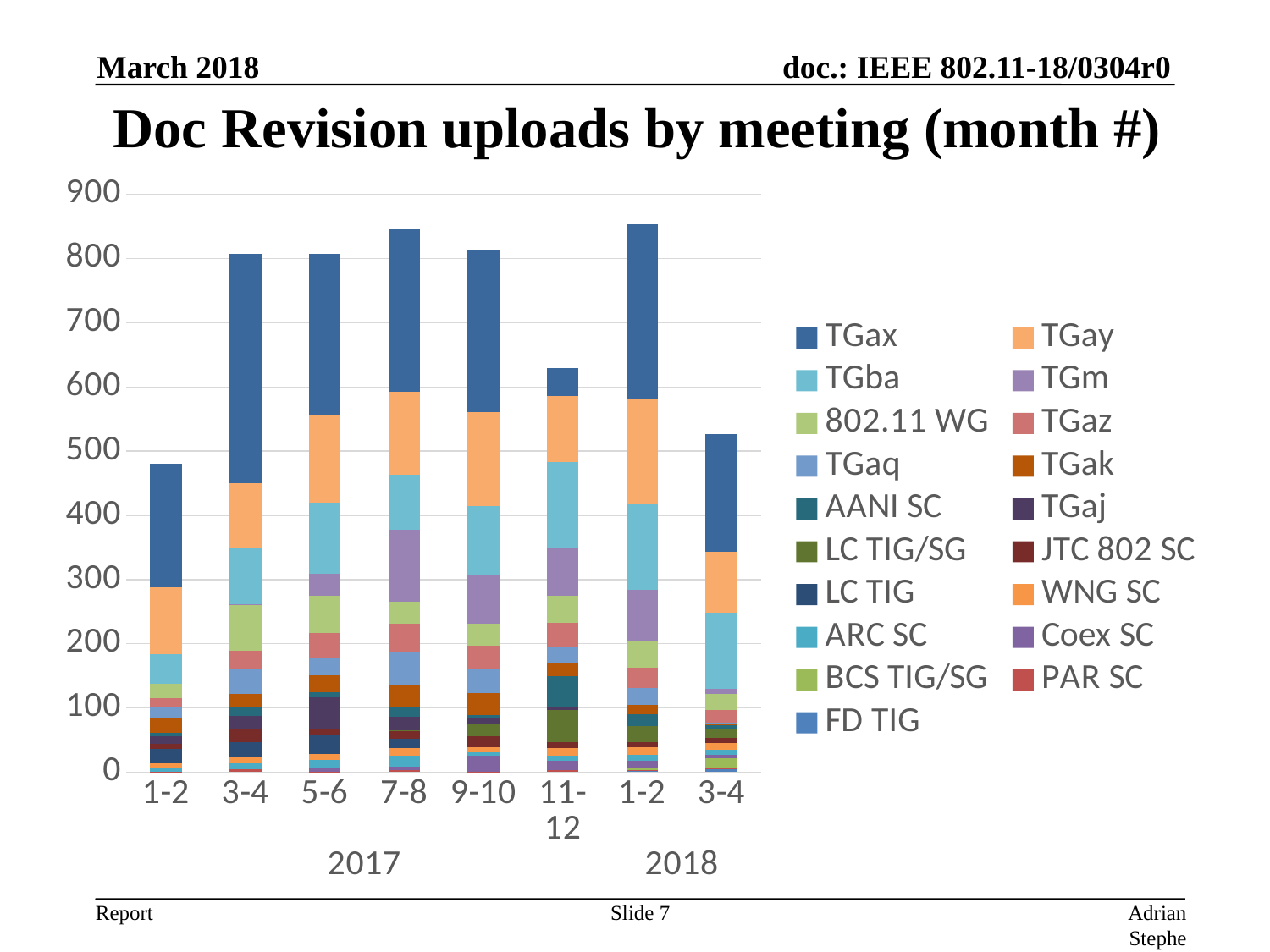
What is the title of the chart? Doc Revision uploads by meeting (month #) How many meeting bars are plotted on the x axis? 8 Is the total for the 2017 11-12 meeting greater or less than 600? greater How many series does the legend list? 19 Which total bar is larger, 2017 9-10 or 2017 11-12? 2017 9-10 Is the total for the 2017 1-2 meeting greater or less than 500? less Which total bar is larger, 2017 1-2 or 2018 3-4? 2018 3-4 Which meeting has the lowest total bar? 1-2 (2017) Is the total for the 2018 3-4 meeting greater or less than 500? greater Which series is shown at the top of each stacked bar in dark blue? TGax What kind of chart is shown on the slide? Stacked bar chart